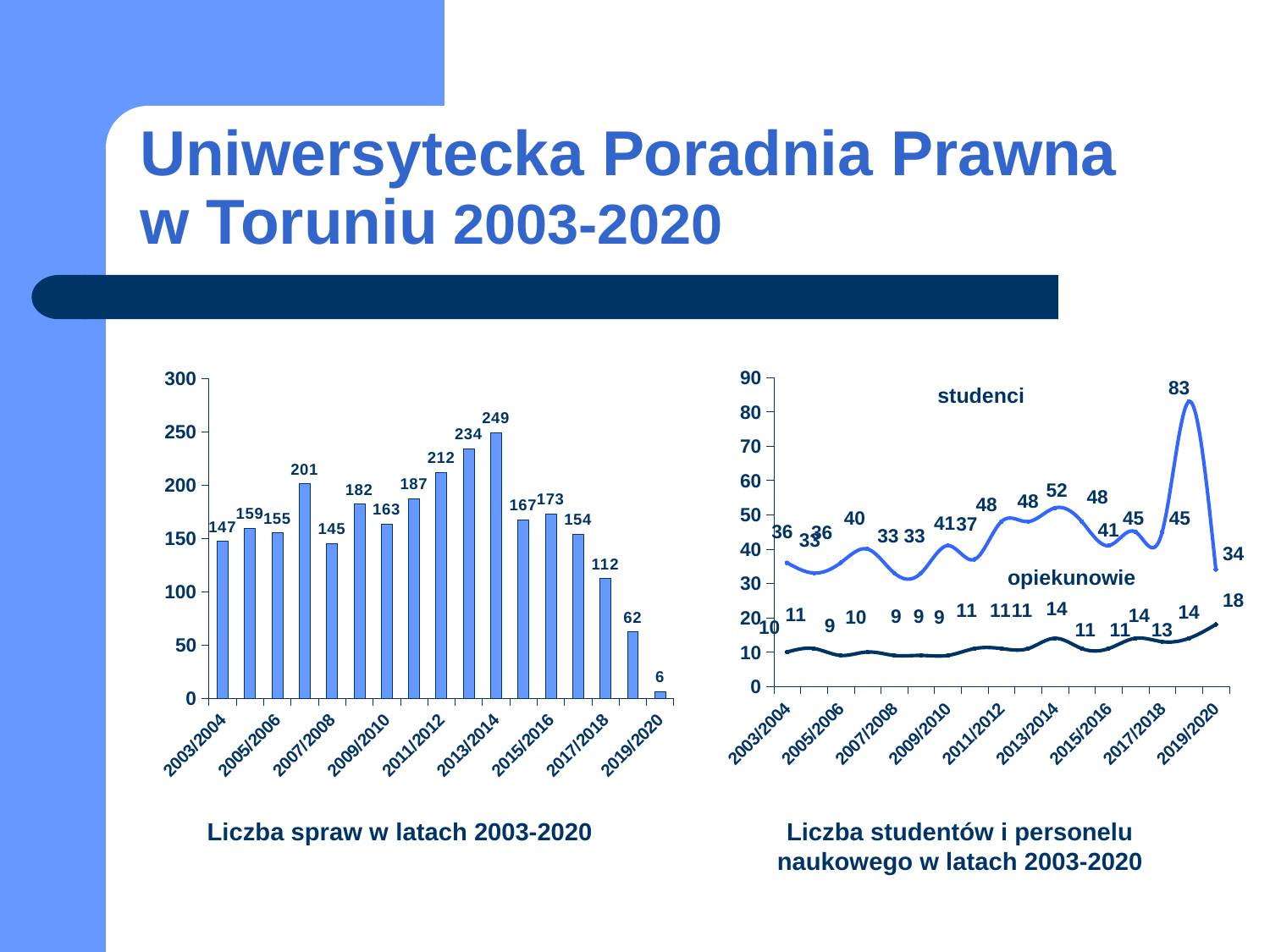
In the chart 'Liczba spraw w latach 2003-2020', which year has the highest number of cases? 2013/2014 What kind of chart is 'Liczba spraw w latach 2003-2020'? bar chart In the chart 'Liczba studentów i personelu naukowego w latach 2003-2020', which series has higher values throughout, 'studenci' or 'opiekunowie'? studenci In the chart 'Liczba studentów i personelu naukowego w latach 2003-2020', what is the highest value of the 'studenci' series? 83 In the chart 'Liczba studentów i personelu naukowego w latach 2003-2020', how many series are plotted? 2 In the chart 'Liczba spraw w latach 2003-2020', what is the value for 2019/2020? 6 In the chart 'Liczba spraw w latach 2003-2020', what is the difference between the highest value (249) and the lowest value (6)? 243 In the chart 'Liczba spraw w latach 2003-2020', what is the value for 2003/2004? 147 In the chart 'Liczba studentów i personelu naukowego w latach 2003-2020', what is the value of 'opiekunowie' for 2019/2020? 18 In the chart 'Liczba spraw w latach 2003-2020', how many bars are plotted? 17 In the chart 'Liczba spraw w latach 2003-2020', what is the highest value shown? 249 In the chart 'Liczba spraw w latach 2003-2020', is the value for 2017/2018 greater or less than 150? less